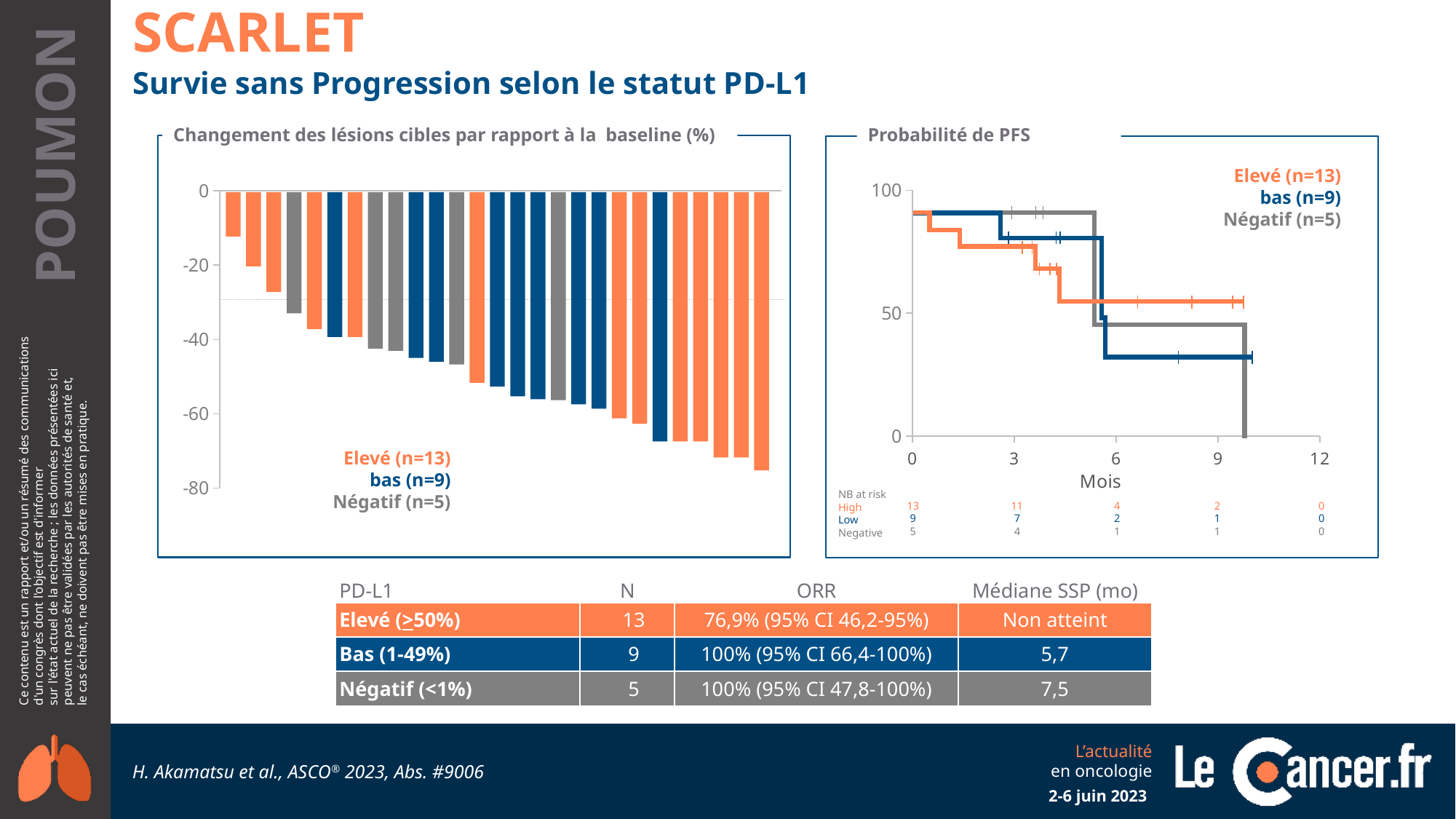
In the right chart 'Probabilité de PFS', how many patients in the High group are at risk at 3 months? 11 In the left chart 'Changement des lésions cibles par rapport à la baseline (%)', is the value of the leftmost bar greater or less than -20? greater In the right chart 'Probabilité de PFS', how many patients in the Negative group are at risk at 0 months? 5 In the right chart 'Probabilité de PFS', which group has the highest PFS probability at 9 months? Elevé (n=13) In the right chart 'Probabilité de PFS', is the PFS probability of the bas (n=9) group at 9 months greater or less than 50? less In the left chart 'Changement des lésions cibles par rapport à la baseline (%)', how many PD-L1 groups does the legend list? 3 In the left chart 'Changement des lésions cibles par rapport à la baseline (%)', what is the lowest value shown on the y axis? -80 In the left chart 'Changement des lésions cibles par rapport à la baseline (%)', do the bar values rise or fall from left to right? fall What kind of chart is the left chart titled 'Changement des lésions cibles par rapport à la baseline (%)'? bar chart In the right chart 'Probabilité de PFS', what is the label of the x axis? Mois In the right chart 'Probabilité de PFS', how many patients in the Low group are at risk at 6 months? 2 In the left chart 'Changement des lésions cibles par rapport à la baseline (%)', is the value of the rightmost bar greater or less than -60? less